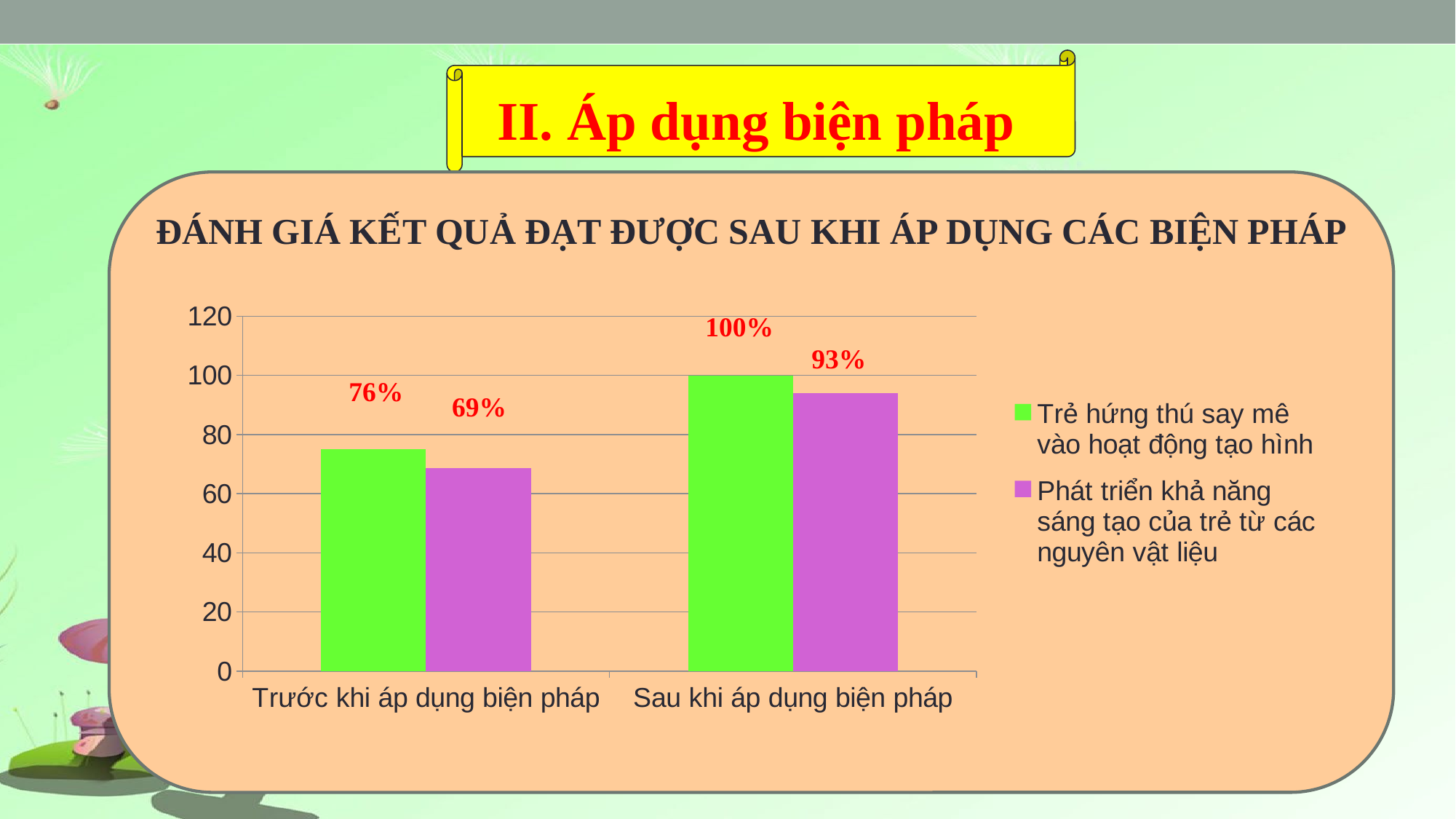
What is the value for "Phát triển khả năng sáng tạo của trẻ từ các nguyên vật liệu" in the "Trước khi áp dụng biện pháp" category? 69% What is the value for "Trẻ hứng thú say mê vào hoạt động tạo hình" in the "Sau khi áp dụng biện pháp" category? 100% What is the value for "Phát triển khả năng sáng tạo của trẻ từ các nguyên vật liệu" in the "Sau khi áp dụng biện pháp" category? 93% Which bar has the highest value in the chart? Trẻ hứng thú say mê vào hoạt động tạo hình, Sau khi áp dụng biện pháp What is the difference between the "Phát triển khả năng sáng tạo của trẻ từ các nguyên vật liệu" values before and after applying the measures? 24% What is the value for "Trẻ hứng thú say mê vào hoạt động tạo hình" in the "Trước khi áp dụng biện pháp" category? 76% Which bar has the lowest value in the chart? Phát triển khả năng sáng tạo của trẻ từ các nguyên vật liệu, Trước khi áp dụng biện pháp What is the difference between the "Trẻ hứng thú say mê vào hoạt động tạo hình" values before and after applying the measures? 24% How many series does the legend list? 2 How many categories are shown on the x axis? 2 What kind of chart is shown on the slide? bar chart In the "Sau khi áp dụng biện pháp" category, which series has the larger value? Trẻ hứng thú say mê vào hoạt động tạo hình